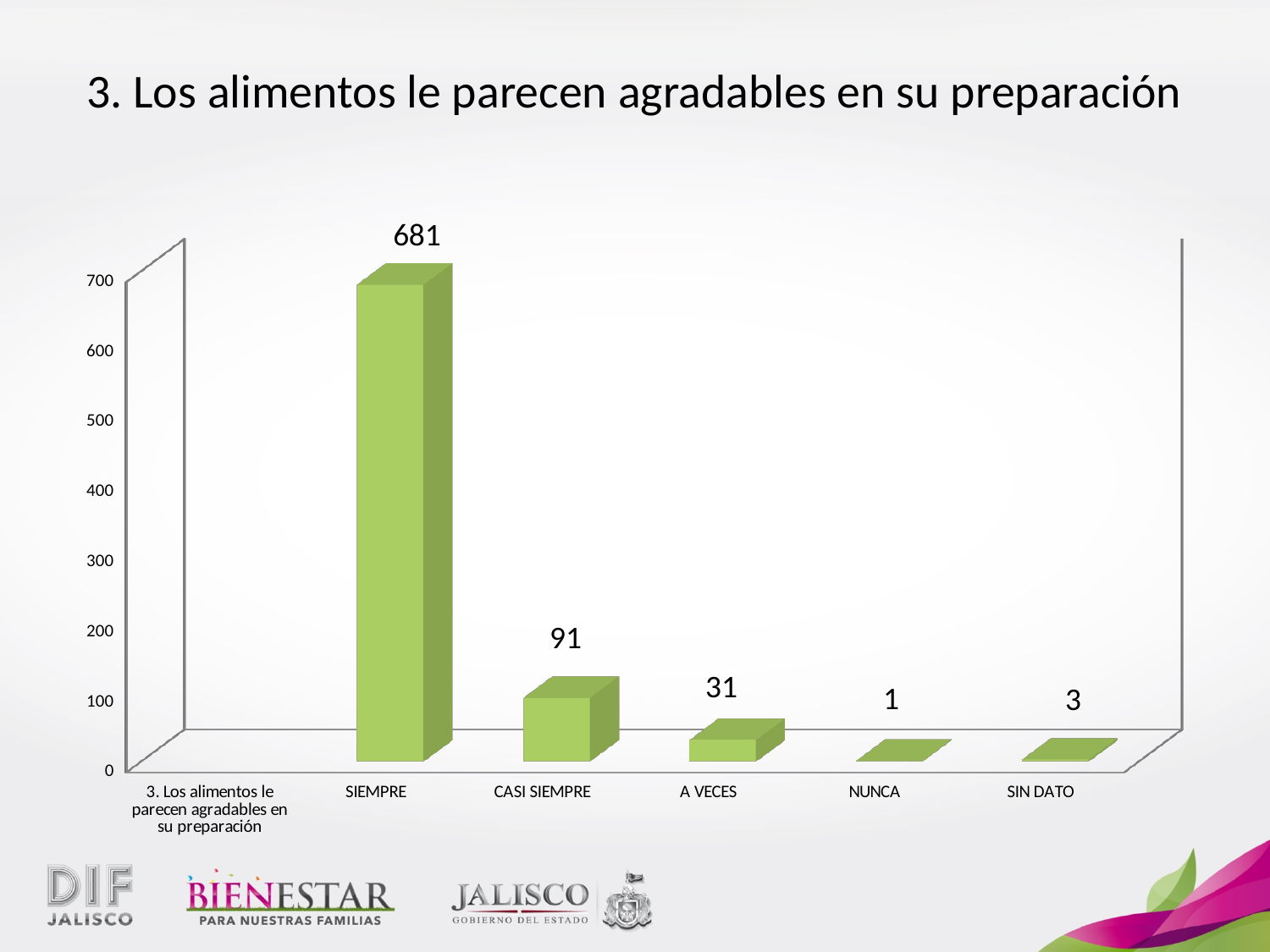
What is the value for SIN DATO? 3 How many bars are plotted in the chart? 5 What is the title of the slide? 3. Los alimentos le parecen agradables en su preparación What is the difference between the values for SIEMPRE and CASI SIEMPRE? 590 What kind of chart is shown on the slide? Bar chart Which category has the lowest value? NUNCA What is the value for A VECES? 31 What is the value for SIEMPRE? 681 What is the value for CASI SIEMPRE? 91 Which category has the highest value? SIEMPRE Which is larger, the value for A VECES or the value for SIN DATO? A VECES What is the value for NUNCA? 1